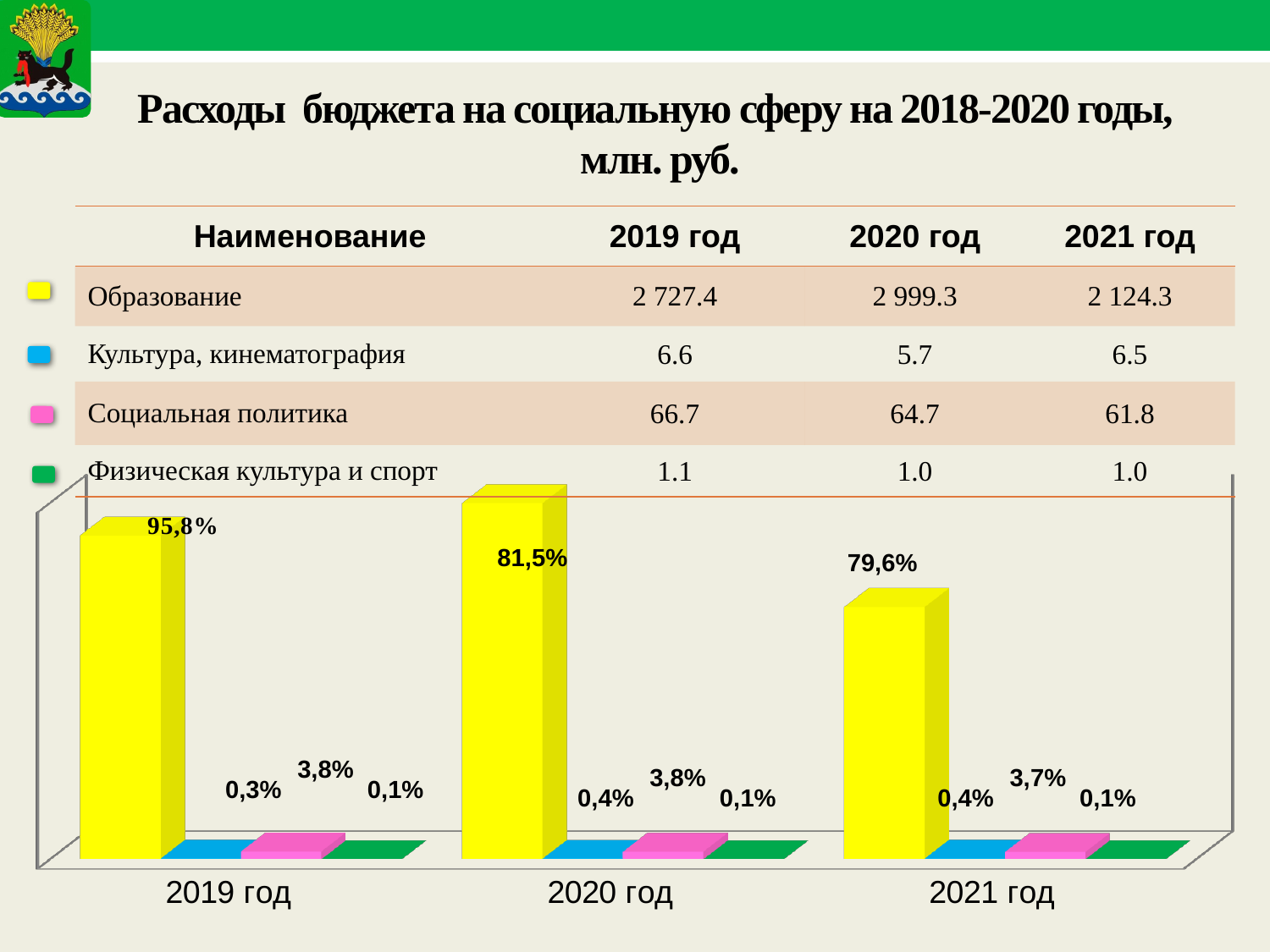
In the bar chart, what is the data label on the yellow (Образование) bar for 2020 год? 81,5% What kind of chart is shown at the bottom of the slide? bar chart In the bar chart, which year has the highest value for the yellow (Образование) bar? 2020 год In the bar chart, what is the data label on the yellow (Образование) bar for 2021 год? 79,6% In the bar chart, what is the data label on the pink (Социальная политика) bar for 2021 год? 3,7% How many year categories are shown on the x axis of the bar chart? 3 In the bar chart, does the yellow (Образование) bar value rise or fall from 2019 год to 2021 год? fall In the bar chart, what is the data label on the blue (Культура, кинематография) bar for 2019 год? 0,3% In the bar chart, what is the data label on the yellow (Образование) bar for 2019 год? 95,8% In the bar chart, what is the data label on the green (Физическая культура и спорт) bar for 2020 год? 0,1% In the bar chart, which year has the lowest value for the yellow (Образование) bar? 2021 год